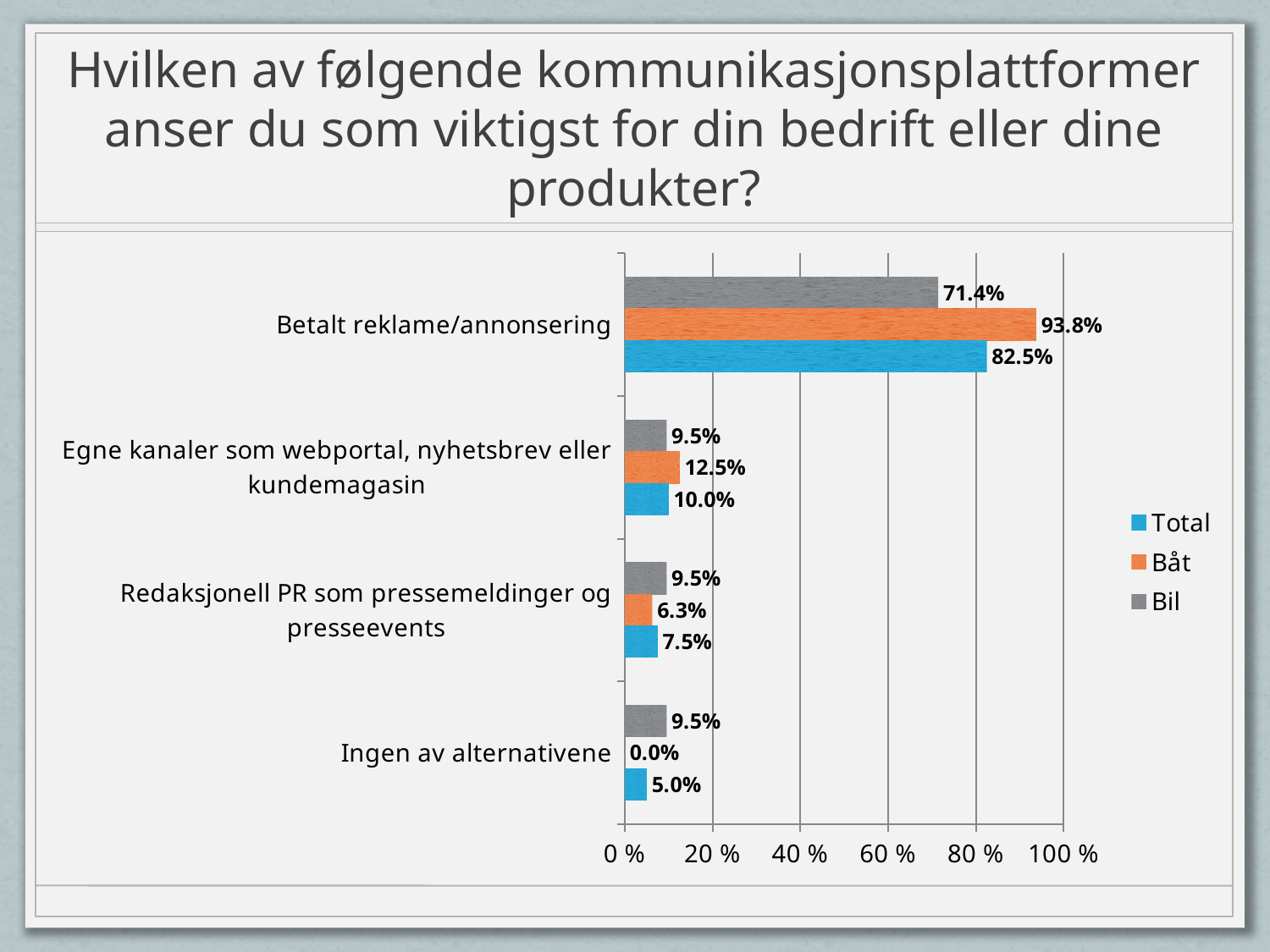
Which category has the lowest Båt value? Ingen av alternativene How many categories are shown on the chart? 4 Which is larger for Egne kanaler som webportal, nyhetsbrev eller kundemagasin: the Båt value or the Bil value? Båt What is the Total value for Egne kanaler som webportal, nyhetsbrev eller kundemagasin? 10.0% What is the difference between the Båt and Bil values for Betalt reklame/annonsering? 22.4% What is the Båt value for Betalt reklame/annonsering? 93.8% What is the Båt value for Redaksjonell PR som pressemeldinger og presseevents? 6.3% Which category has the highest Total value? Betalt reklame/annonsering What is the Bil value for Ingen av alternativene? 9.5% Which colour represents the Total series in the legend? Blue What kind of chart is shown on the slide? Bar chart How many series does the legend list? 3